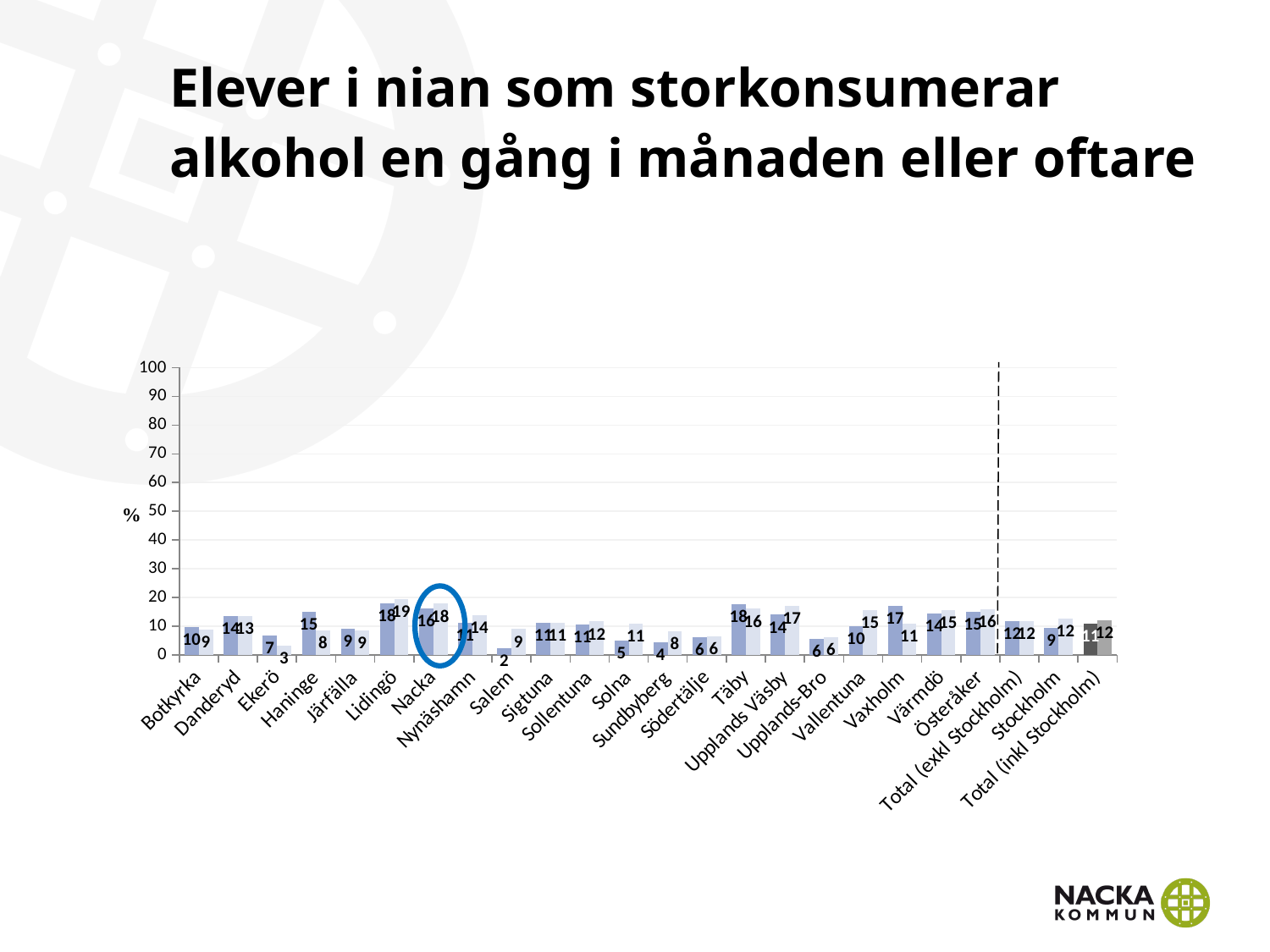
Is the value of the first (darker) bar for Lidingö greater or less than 10? greater What is the value of the second (lighter) bar for Nacka? 18 What is the value of the first (darker) bar for Vaxholm? 17 Which category on the chart is circled in blue? Nacka Which is larger for Solna: the first (darker) bar or the second (lighter) bar? the second (lighter) bar How many categories are shown along the x axis? 24 What is the difference between the two bars for Haninge (15 and 8)? 7 What is the value of the first (darker) bar for Salem? 2 What is the value of the second (lighter) bar for Ekerö? 3 What is the value of the first (darker) bar for Nacka? 16 Which municipality has the lowest value for the first (darker) bar? Salem What kind of chart is shown on the slide? bar chart